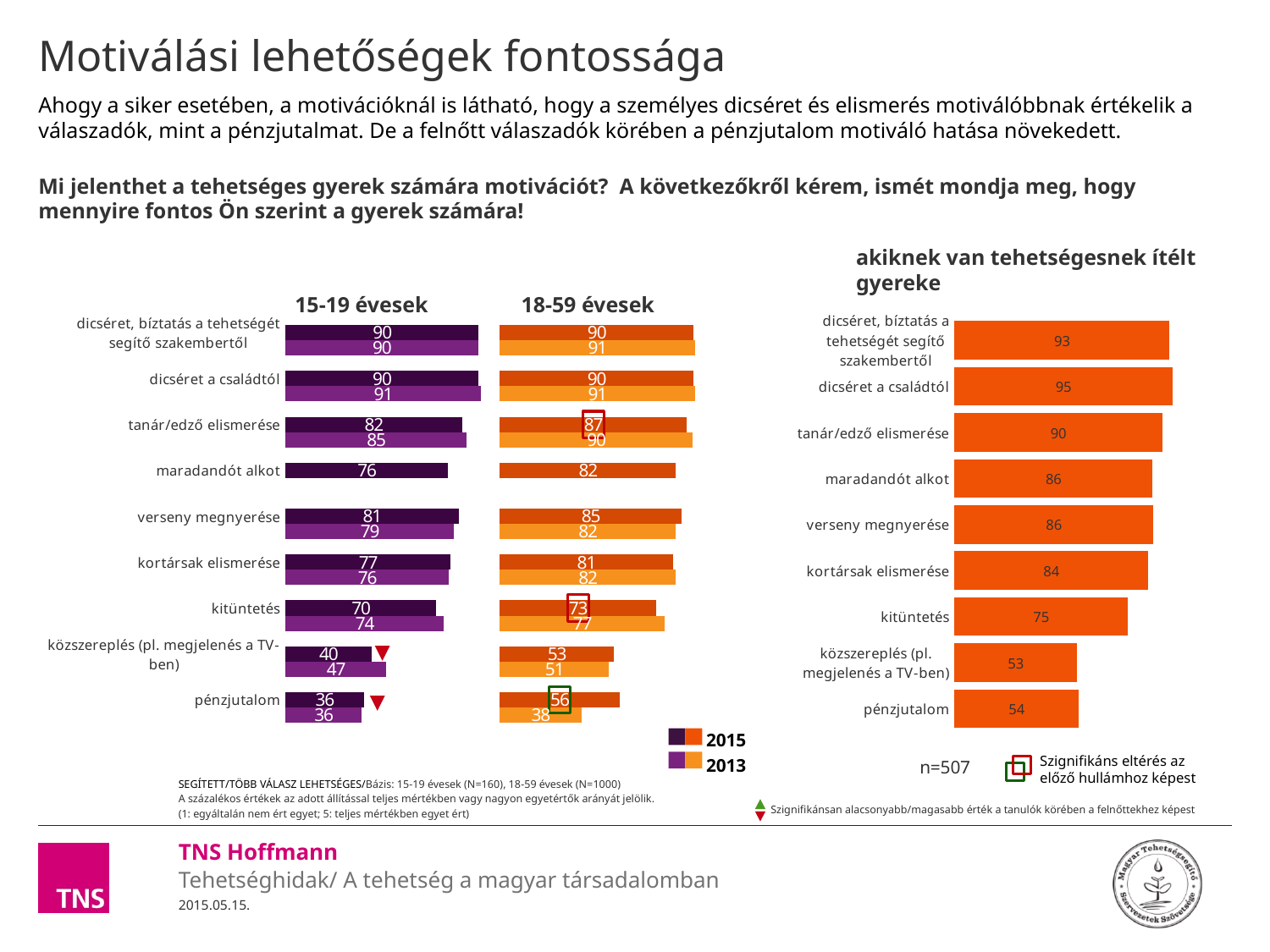
In the 'akiknek van tehetségesnek ítélt gyereke' chart, what is the value for 'tanár/edző elismerése'? 90 What type of chart is the 'akiknek van tehetségesnek ítélt gyereke' chart? bar chart In the '15-19 évesek' chart, what is the 2013 value for 'közszereplés (pl. megjelenés a TV-ben)'? 47 In the '18-59 évesek' chart, what is the difference between the 2015 and 2013 values for 'pénzjutalom'? 18 In the '18-59 évesek' chart, what is the 2015 value for 'pénzjutalom'? 56 In the '18-59 évesek' chart, what is the 2013 value for 'kitüntetés'? 77 In the 'akiknek van tehetségesnek ítélt gyereke' chart, which category has the highest value? dicséret a családtól How many series does the legend list for the '15-19 évesek' and '18-59 évesek' charts? 2 How many categories are shown in the 'akiknek van tehetségesnek ítélt gyereke' chart? 9 In the '15-19 évesek' chart, what is the 2015 value for 'pénzjutalom'? 36 In the '15-19 évesek' chart, which is larger for 'kitüntetés': the 2015 value or the 2013 value? 2013 In the 'akiknek van tehetségesnek ítélt gyereke' chart, which category has the lowest value? közszereplés (pl. megjelenés a TV-ben)